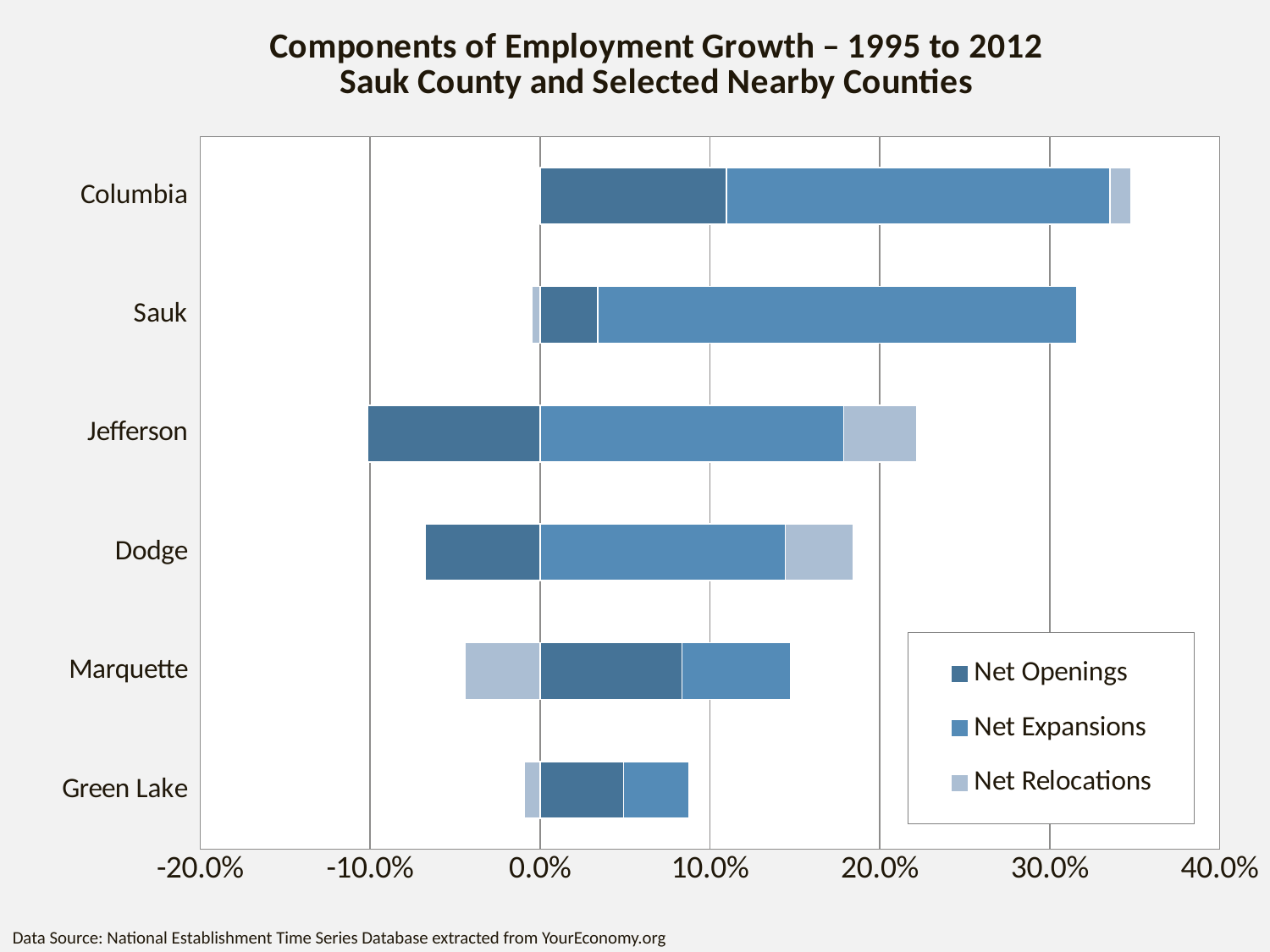
What is the title of the chart? Components of Employment Growth – 1995 to 2012 Sauk County and Selected Nearby Counties Is the Net Expansions value for Dodge greater or less than 10.0%? greater Which county has the larger Net Openings value, Columbia or Sauk? Columbia Which county has the most negative Net Openings value? Jefferson How many series does the legend list? 3 What kind of chart is shown on the slide? bar chart Is the Net Openings value for Columbia greater or less than 10.0%? greater Is the Net Openings value for Jefferson greater or less than 0.0%? less Which county has the largest Net Expansions value? Sauk How many counties are plotted on the chart? 6 What are the three series listed in the legend? Net Openings, Net Expansions, Net Relocations